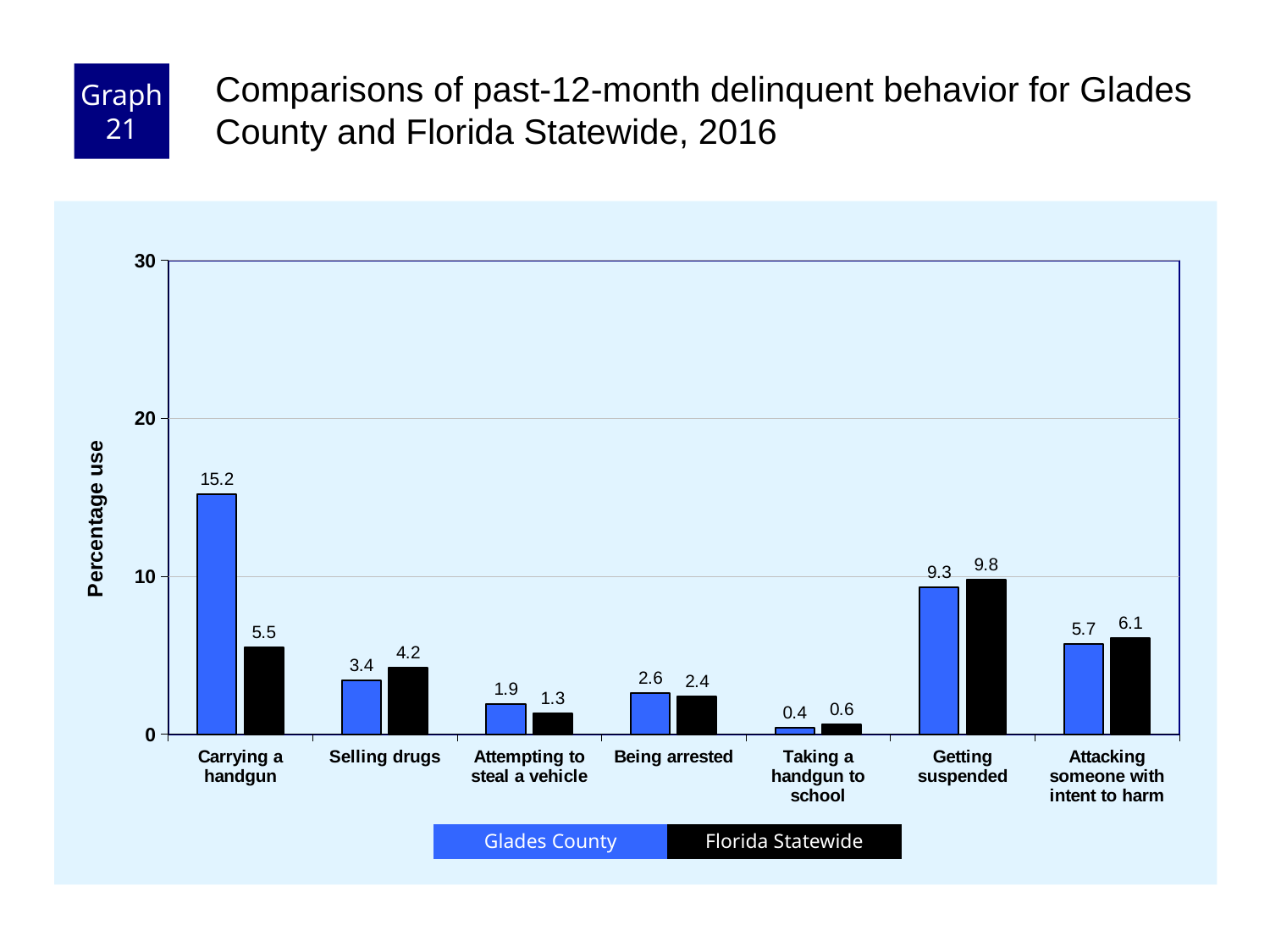
Which category has the lowest Florida Statewide value? Taking a handgun to school Which is larger for Attempting to steal a vehicle, Glades County or Florida Statewide? Glades County Which category has the highest Glades County value? Carrying a handgun What kind of chart is shown on the slide? Bar chart What is the Florida Statewide value for Getting suspended? 9.8 What is the difference between the Florida Statewide and Glades County values for Selling drugs? 0.8 What is the Glades County value for Carrying a handgun? 15.2 How many categories are shown on the x axis? 7 Is the Glades County value for Carrying a handgun greater or less than 10? greater How many series does the legend list? 2 What is the difference between the Glades County and Florida Statewide values for Carrying a handgun? 9.7 What is the Glades County value for Taking a handgun to school? 0.4